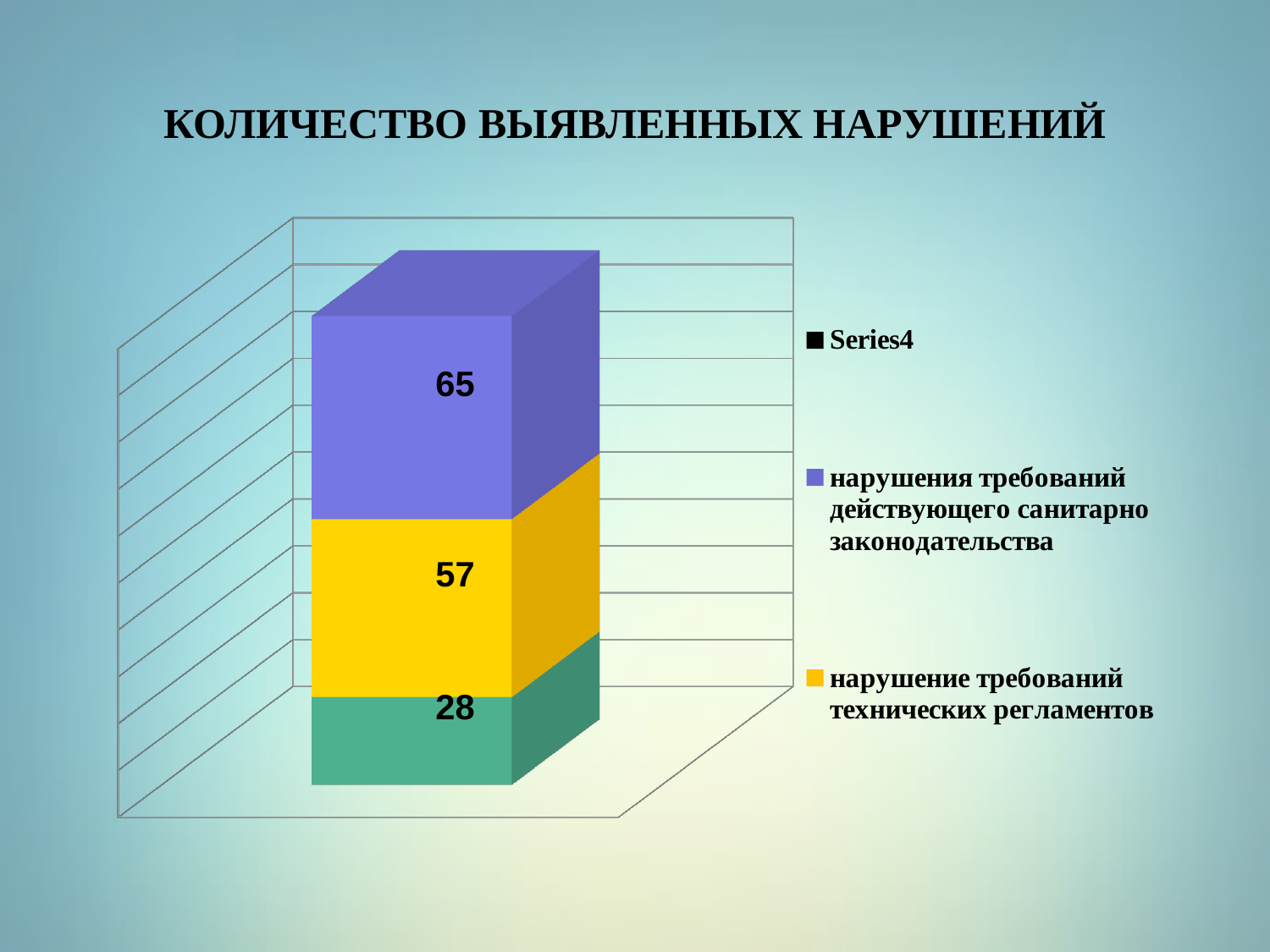
What type of chart is shown on the slide? Stacked bar chart What is the value shown for the series 'нарушение требований технических регламентов'? 57 What is the total of all segments in the stacked bar? 150 What is the difference between the value for 'нарушения требований действующего санитарно законодательства' and the value for 'нарушение требований технических регламентов'? 8 Which is larger: the value for 'нарушение требований технических регламентов' or the value of the bottom green segment? нарушение требований технических регламентов What is the value shown for the series 'нарушения требований действующего санитарно законодательства'? 65 What value is labelled on the bottom (green) segment of the stacked bar? 28 What is the difference between the value for 'нарушение требований технических регламентов' and the bottom green segment's value? 29 How many segments make up the stacked bar? 3 How many entries does the legend list? 3 What is the smallest value labelled on the stacked bar? 28 Which segment of the stacked bar has the largest value? нарушения требований действующего санитарно законодательства (65)